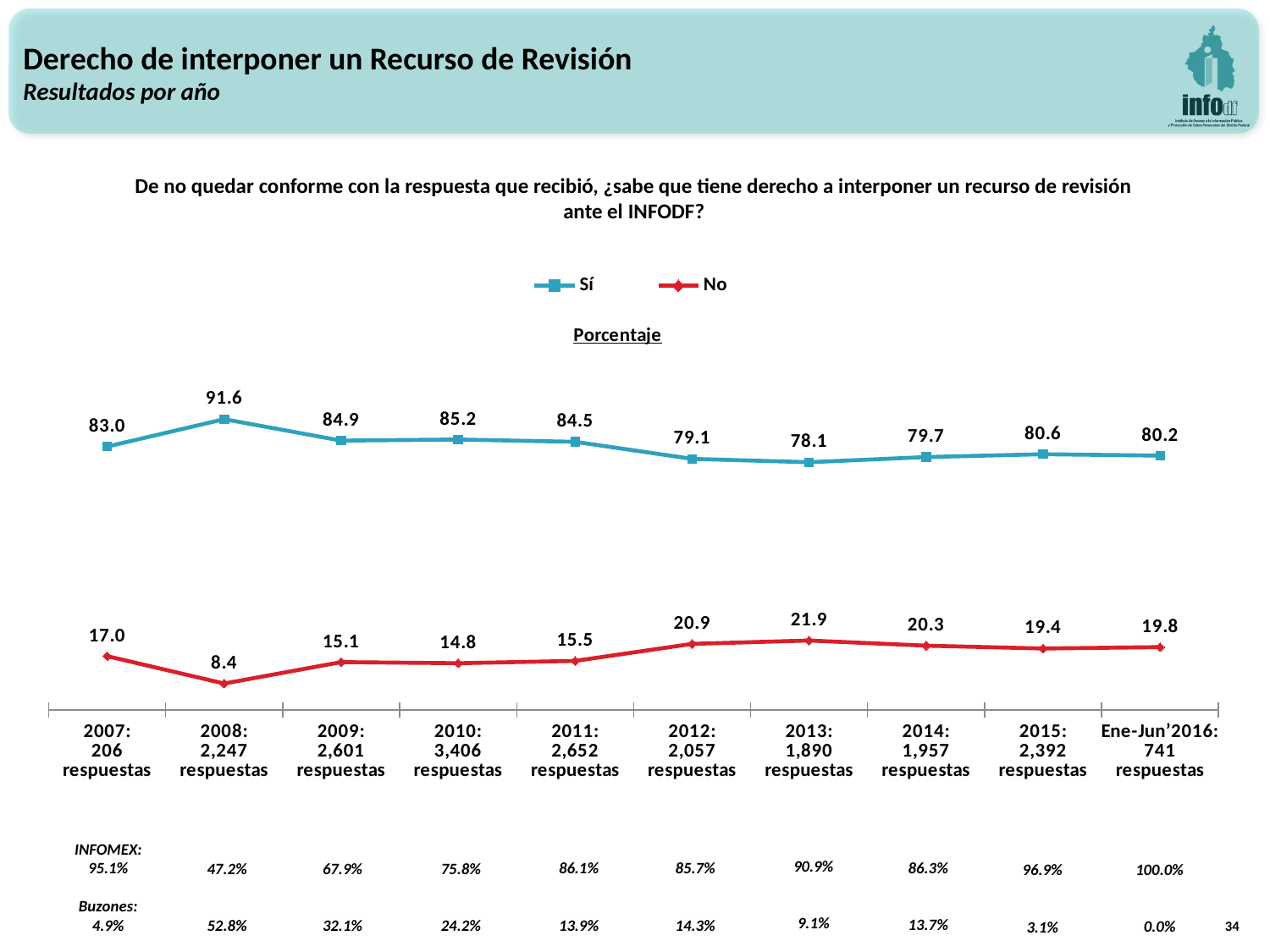
What is the value of the "Sí" series for Ene-Jun'2016? 80.2 Does the "No" series rise or fall from 2011 to 2013? Rise In which year does the "Sí" series reach its highest value? 2008 Which is larger: the "No" value for 2012 or the "No" value for 2015? 2012 What kind of chart is shown on the slide? Line chart In which year does the "Sí" series have its lowest value? 2013 How many years (data points) are shown on the x axis of the chart? 10 What is the value of the "Sí" series for 2008? 91.6 How many series does the legend list? 2 In which year does the "No" series have its lowest value? 2008 What is the difference between the "Sí" values for 2008 and 2013? 13.5 What is the value of the "No" series for 2013? 21.9